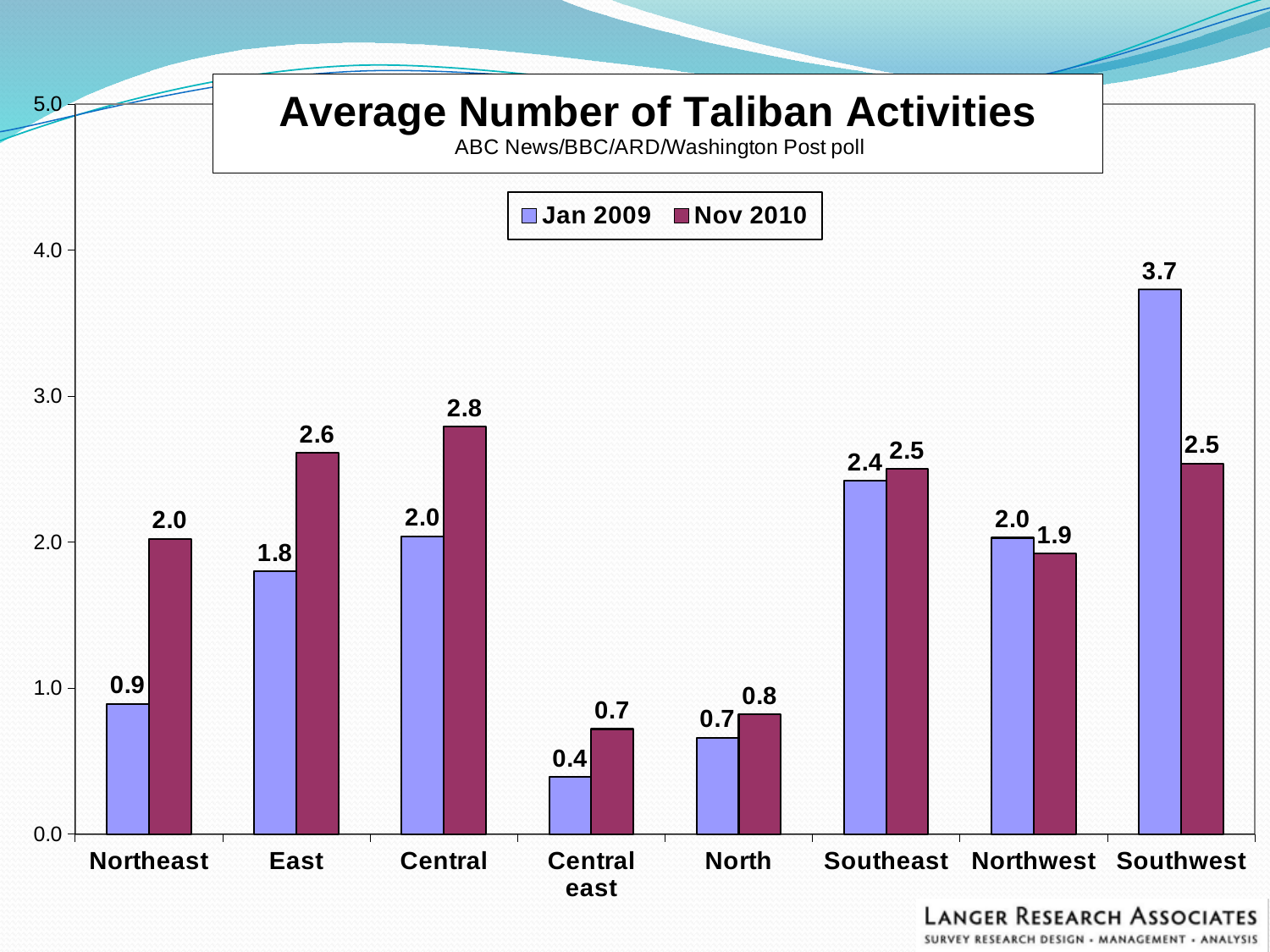
What is the Jan 2009 value for Southwest? 3.7 What is the title of the chart? Average Number of Taliban Activities What is the Nov 2010 value for Central? 2.8 What kind of chart is shown? Bar chart What is the Jan 2009 value for Central east? 0.4 How many series does the legend list? 2 What is the difference between the Jan 2009 and Nov 2010 values for Northeast? 1.1 Which region has the lowest Nov 2010 value? Central east Which is larger for Southwest, the Jan 2009 value or the Nov 2010 value? Jan 2009 Which poll is cited in the chart subtitle? ABC News/BBC/ARD/Washington Post poll Which region has the highest Jan 2009 value? Southwest How many regions are shown on the x axis? 8